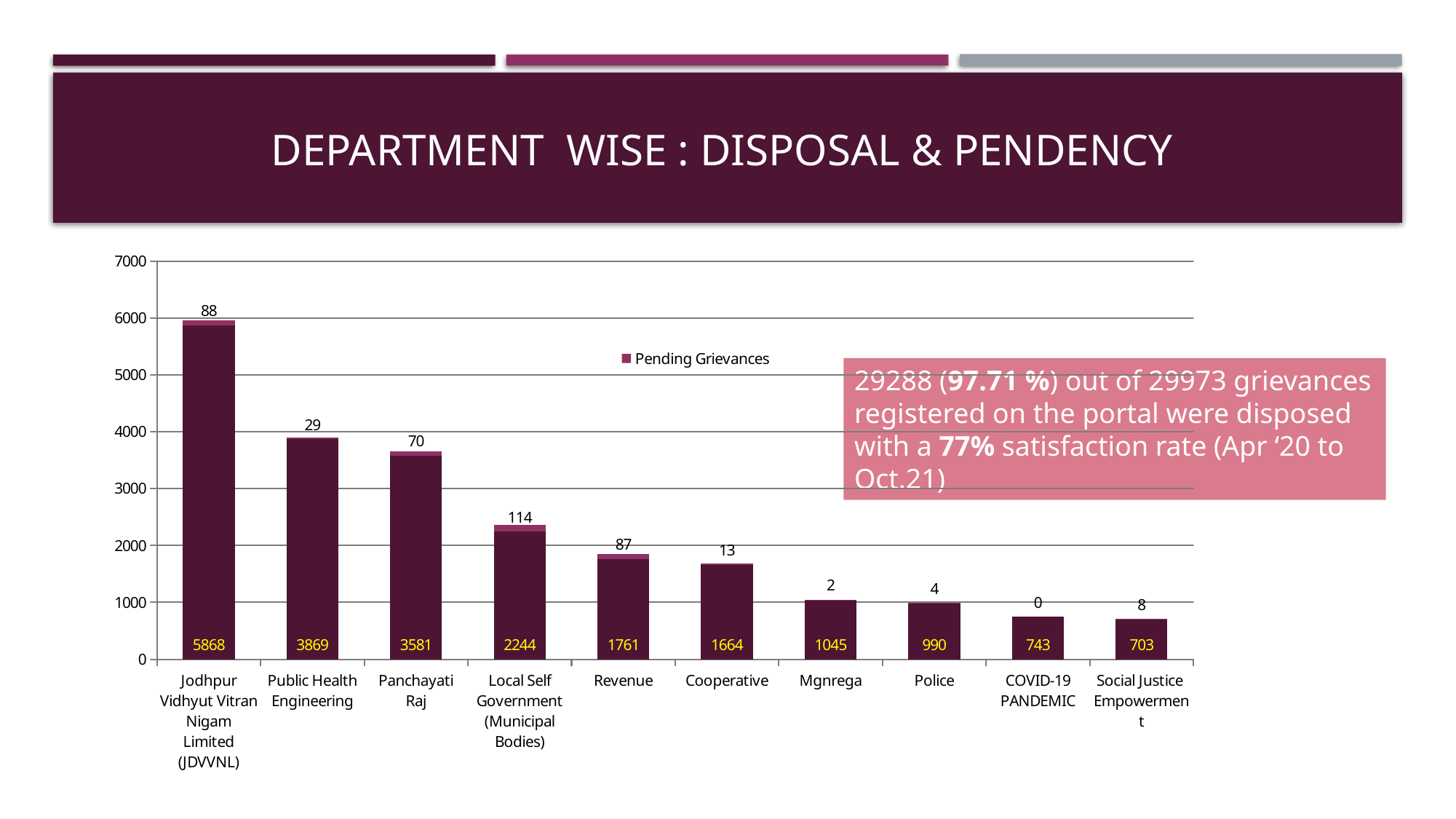
Which department has the lowest value shown inside its bar? Social Justice Empowerment Which department has the highest number of pending grievances? Local Self Government (Municipal Bodies) How many departments are shown on the x axis? 10 What is the total of the stacked bar for Jodhpur Vidhyut Vitran Nigam Limited (JDVVNL)? 5956 What kind of chart is shown on the slide? Bar chart What is the number of pending grievances for COVID-19 PANDEMIC? 0 What is the difference between the yellow-labelled values for Public Health Engineering and Panchayati Raj? 288 Is the total height of the Mgnrega bar greater or less than 1000? greater Which has more pending grievances, Revenue or Cooperative? Revenue What is the number of pending grievances for Local Self Government (Municipal Bodies)? 114 Which department has the highest value shown inside its bar? Jodhpur Vidhyut Vitran Nigam Limited (JDVVNL) What is the value shown in yellow inside the bar for Revenue? 1761